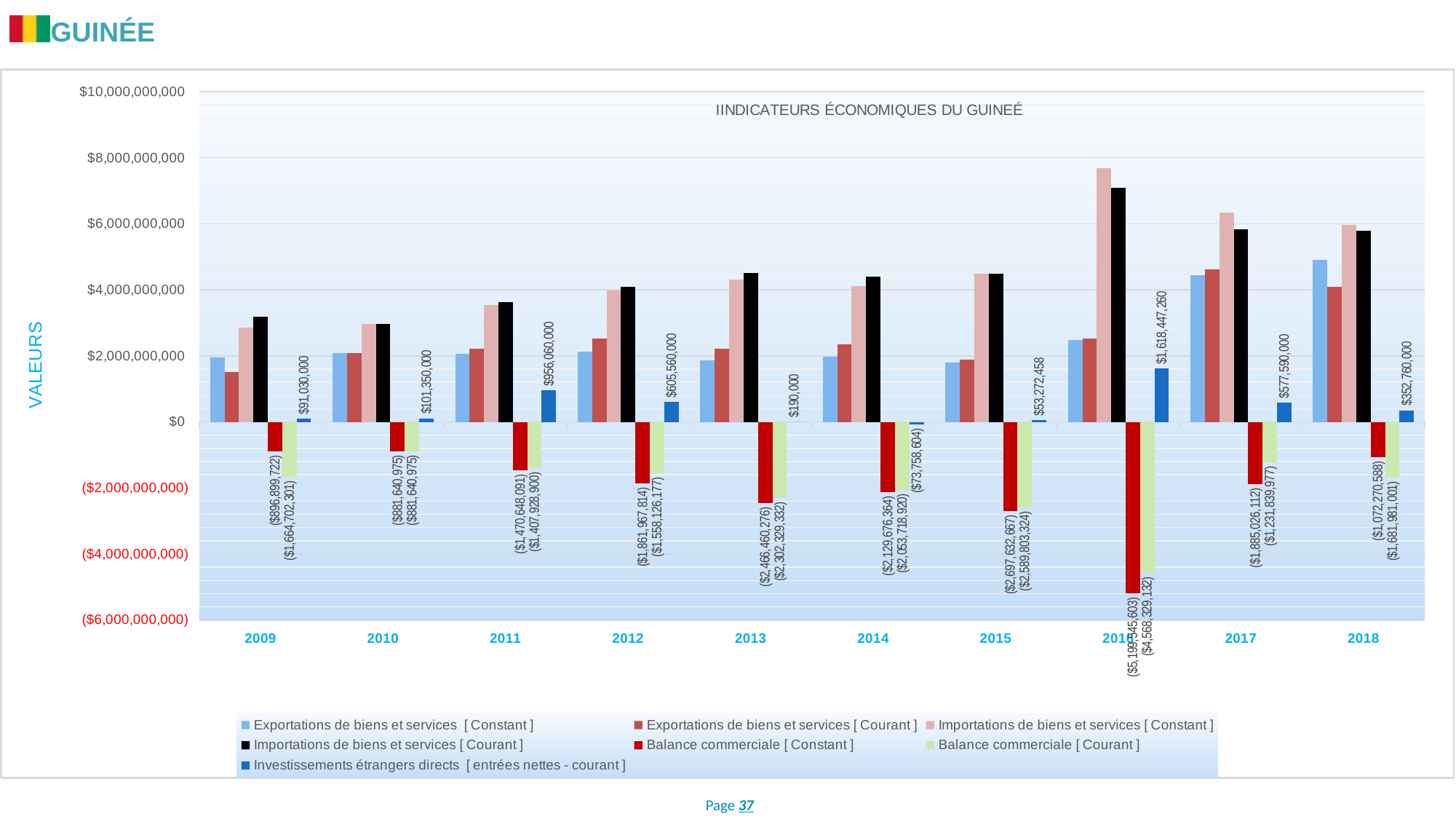
Is the value of Exportations de biens et services [Constant] in 2018 greater or less than $4,000,000,000? greater How many series does the legend list? 7 Is the value of Importations de biens et services [Courant] in 2016 greater or less than $6,000,000,000? greater In which year is Investissements étrangers directs highest? 2016 What kind of chart is shown on the slide? bar chart How many years are shown on the x axis? 10 What is the value of Balance commerciale [Courant] in 2016? ($4,568,329,132) Which year has the larger value of Investissements étrangers directs, 2011 or 2012? 2011 In which year is Investissements étrangers directs lowest? 2014 What is the value of Balance commerciale [Constant] in 2013? ($2,466,460,276) What is the value of Investissements étrangers directs in 2011? $956,060,000 What is the difference between Investissements étrangers directs in 2017 and in 2018? $224,830,000